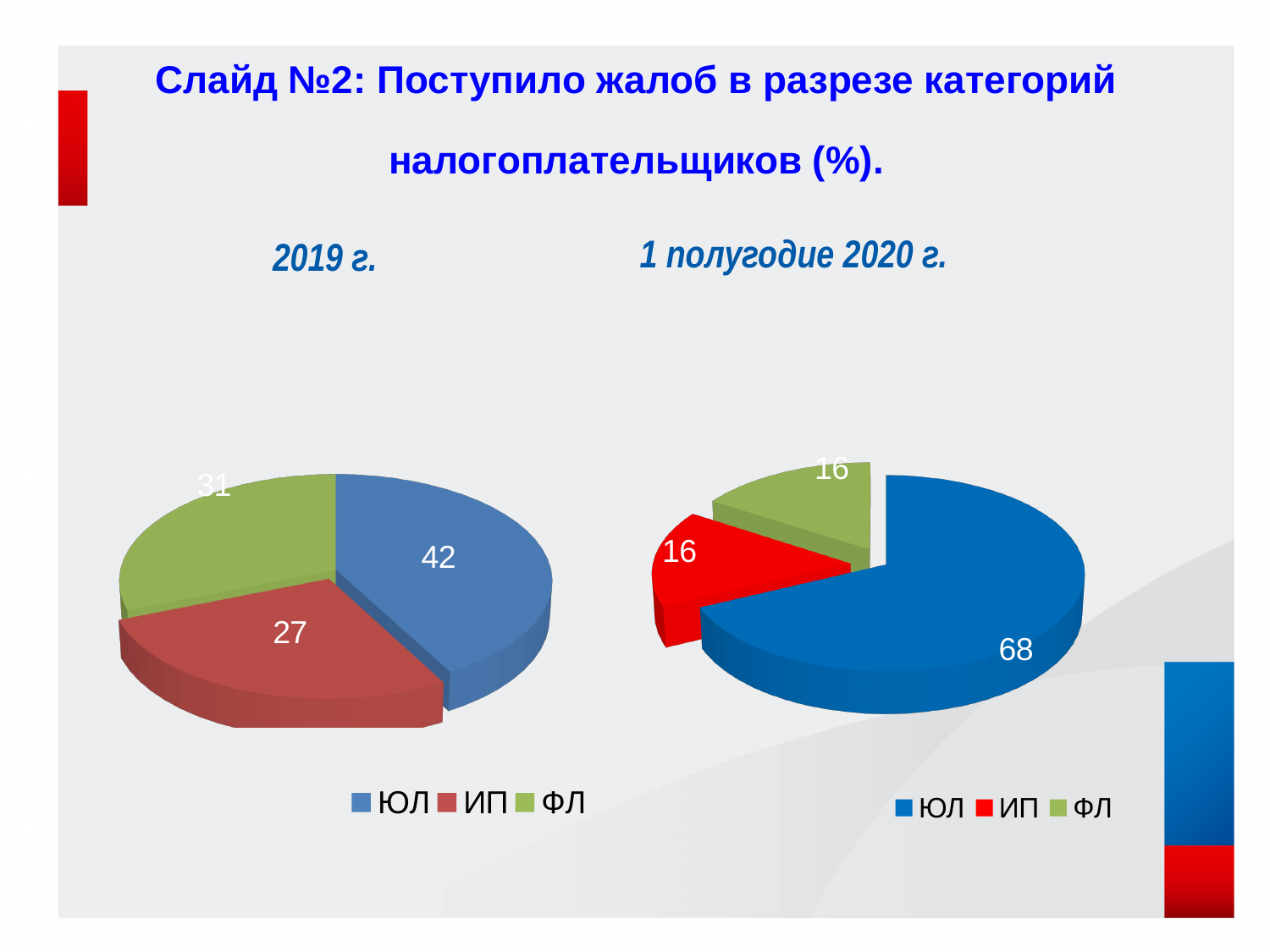
In the 2019 г. pie chart, what is the value for ЮЛ? 42 In the 1 полугодие 2020 г. pie chart, which category has the largest slice? ЮЛ In the 2019 г. pie chart, what is the value for ИП? 27 In the 2019 г. pie chart, which category has the smallest slice? ИП In the 2019 г. pie chart, which category has the largest slice? ЮЛ Which is larger: the value for ЮЛ in the 2019 г. chart or the value for ЮЛ in the 1 полугодие 2020 г. chart? 1 полугодие 2020 г. In the 2019 г. pie chart, what is the difference between the values for ЮЛ and ИП? 15 In the 1 полугодие 2020 г. pie chart, what is the difference between the values for ЮЛ and ИП? 52 In the 1 полугодие 2020 г. pie chart, what is the value for ЮЛ? 68 What type of chart is used for the 1 полугодие 2020 г. data? Pie chart How many categories does the 2019 г. pie chart show? 3 In the 1 полугодие 2020 г. pie chart, what is the value for ФЛ? 16